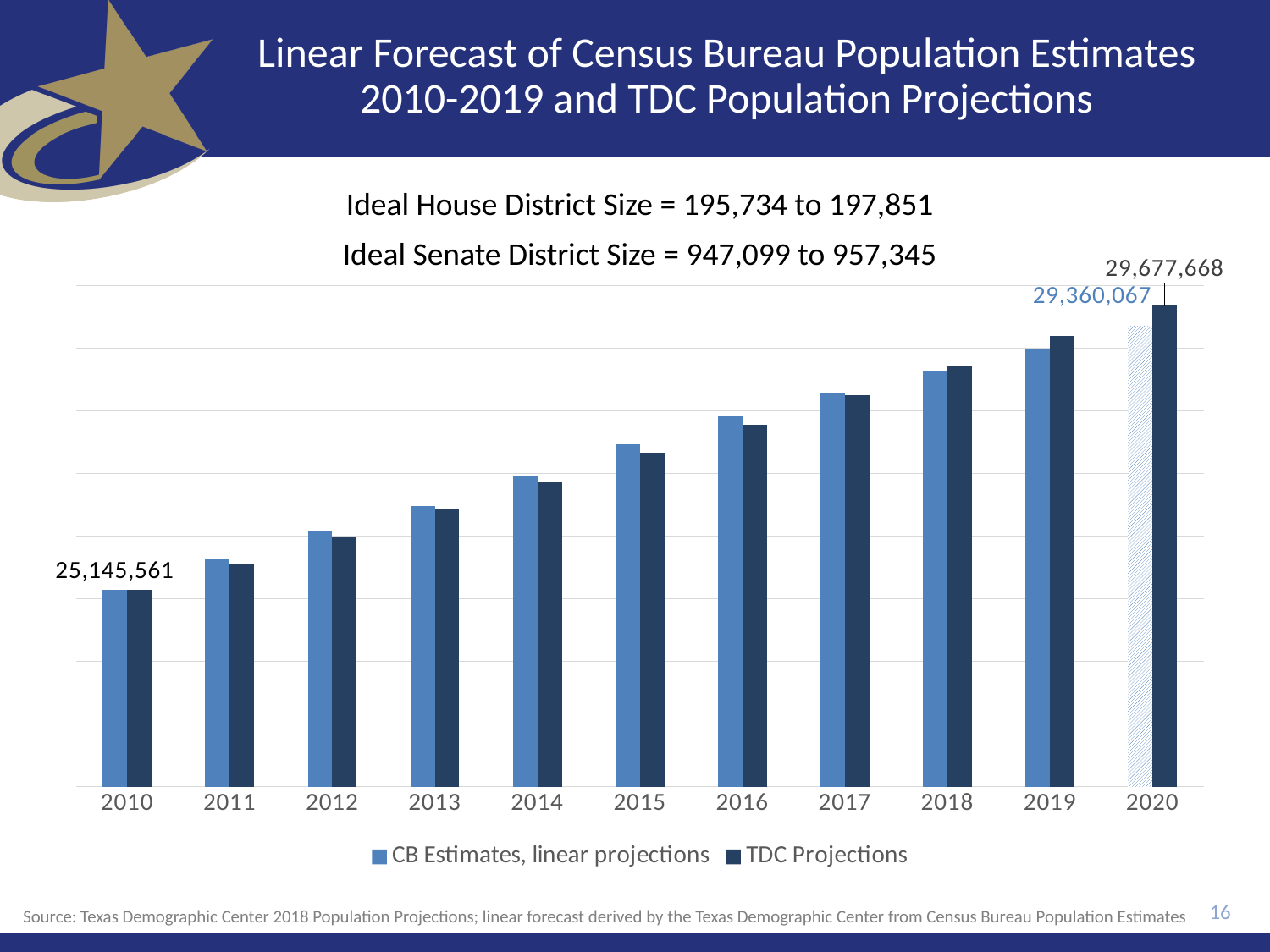
Do the values rise or fall from 2010 to 2020? rise What is the difference between the TDC Projections value and the CB Estimates value labeled for 2020? 317,601 In 2016, which series has the larger value: CB Estimates, linear projections or TDC Projections? CB Estimates, linear projections What type of chart is shown on the slide? bar chart What population value is labeled for 2010? 25,145,561 How many years are shown on the x axis of the chart? 11 How many series does the chart legend list? 2 Which year has the lowest bars in the chart? 2010 In 2019, which series has the larger value: CB Estimates, linear projections or TDC Projections? TDC Projections Which year has the highest bars in the chart? 2020 What is the CB Estimates, linear projections value labeled for 2020? 29,360,067 What is the TDC Projections value labeled for 2020? 29,677,668